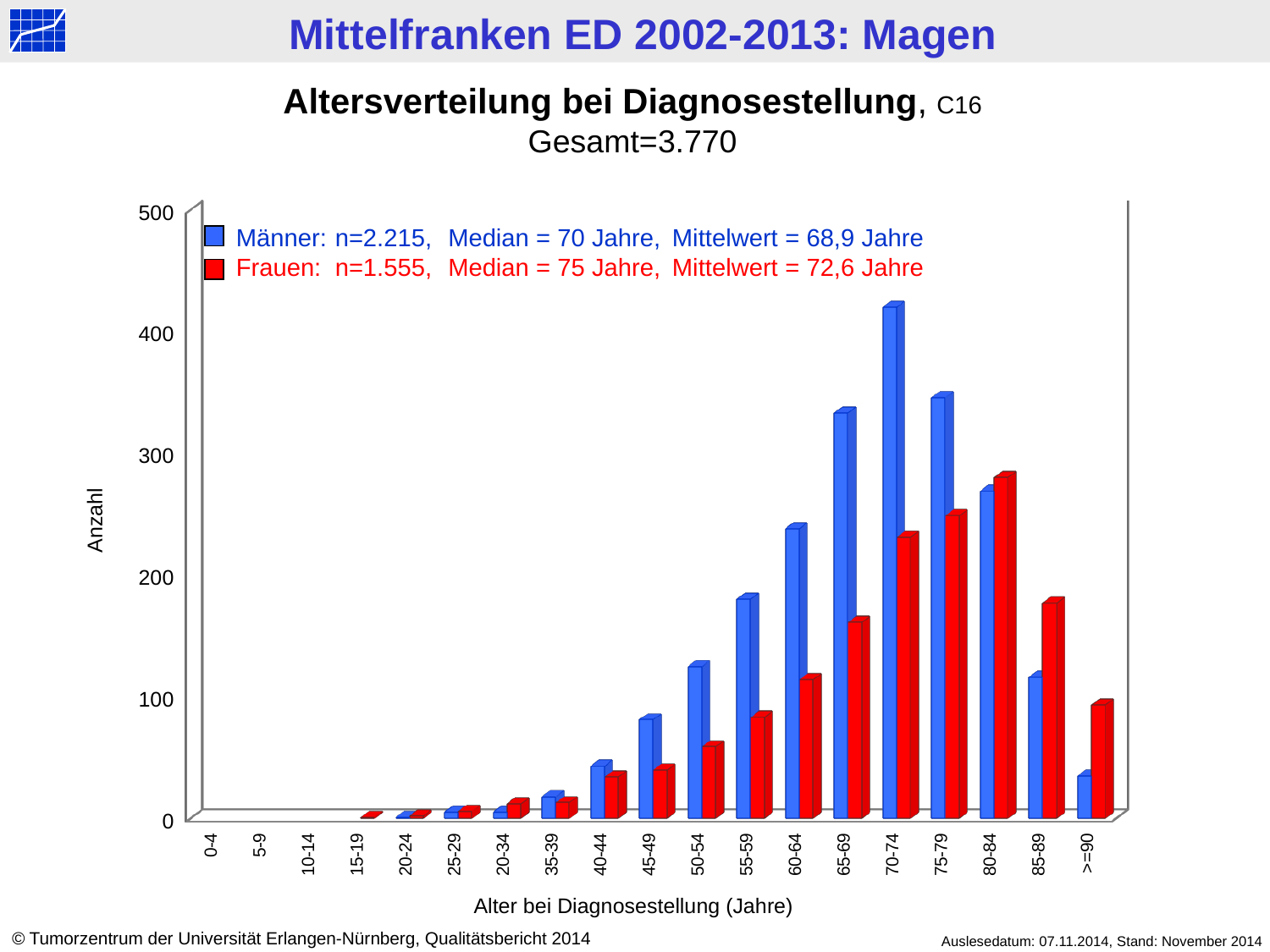
How many age groups are shown on the x axis? 19 Which age group has the highest value for Frauen? 80-84 In the 85-89 age group, which series has the larger value, Männer or Frauen? Frauen Is the value for Frauen in the 80-84 age group greater or less than 300? less What kind of chart is shown on the slide? bar chart According to the legend, what is the median age for Frauen? 75 Jahre Is the value for Männer in the 70-74 age group greater or less than 400? greater Is the value for Männer in the 65-69 age group greater or less than 300? greater In the 70-74 age group, which series has the larger value, Männer or Frauen? Männer How many series does the legend list? 2 Which age group has the highest value for Männer? 70-74